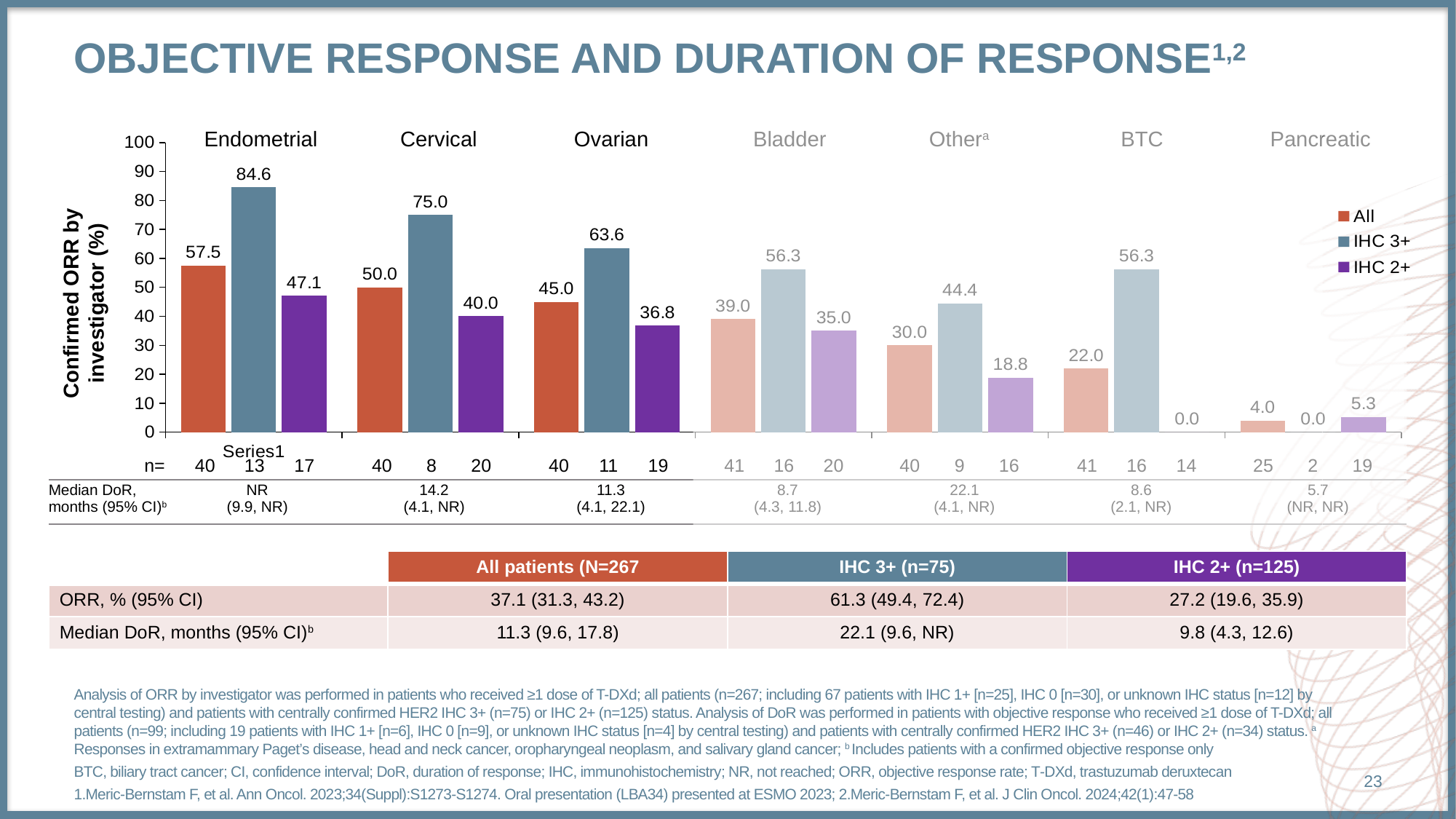
Which tumor group has the lowest confirmed ORR for the All series? Pancreatic Does the All series confirmed ORR rise or fall moving from Endometrial to Pancreatic along the x axis? Fall What is the confirmed ORR for the IHC 2+ series in the Ovarian group? 36.8 How many tumor groups are shown on the x axis of the chart? 7 What kind of chart is used to show confirmed ORR by investigator? Bar chart How many series does the chart legend list? 3 Which tumor group has the highest IHC 3+ confirmed ORR? Endometrial What is the difference between the IHC 3+ and IHC 2+ confirmed ORR in the Cervical group? 35.0 What is the confirmed ORR for the IHC 2+ series in the BTC group? 0.0 Which is larger: the All series ORR for Bladder or the All series ORR for Other? Bladder What is the confirmed ORR for the All series in the Cervical group? 50.0 What is the confirmed ORR for the IHC 3+ series in the Endometrial group? 84.6